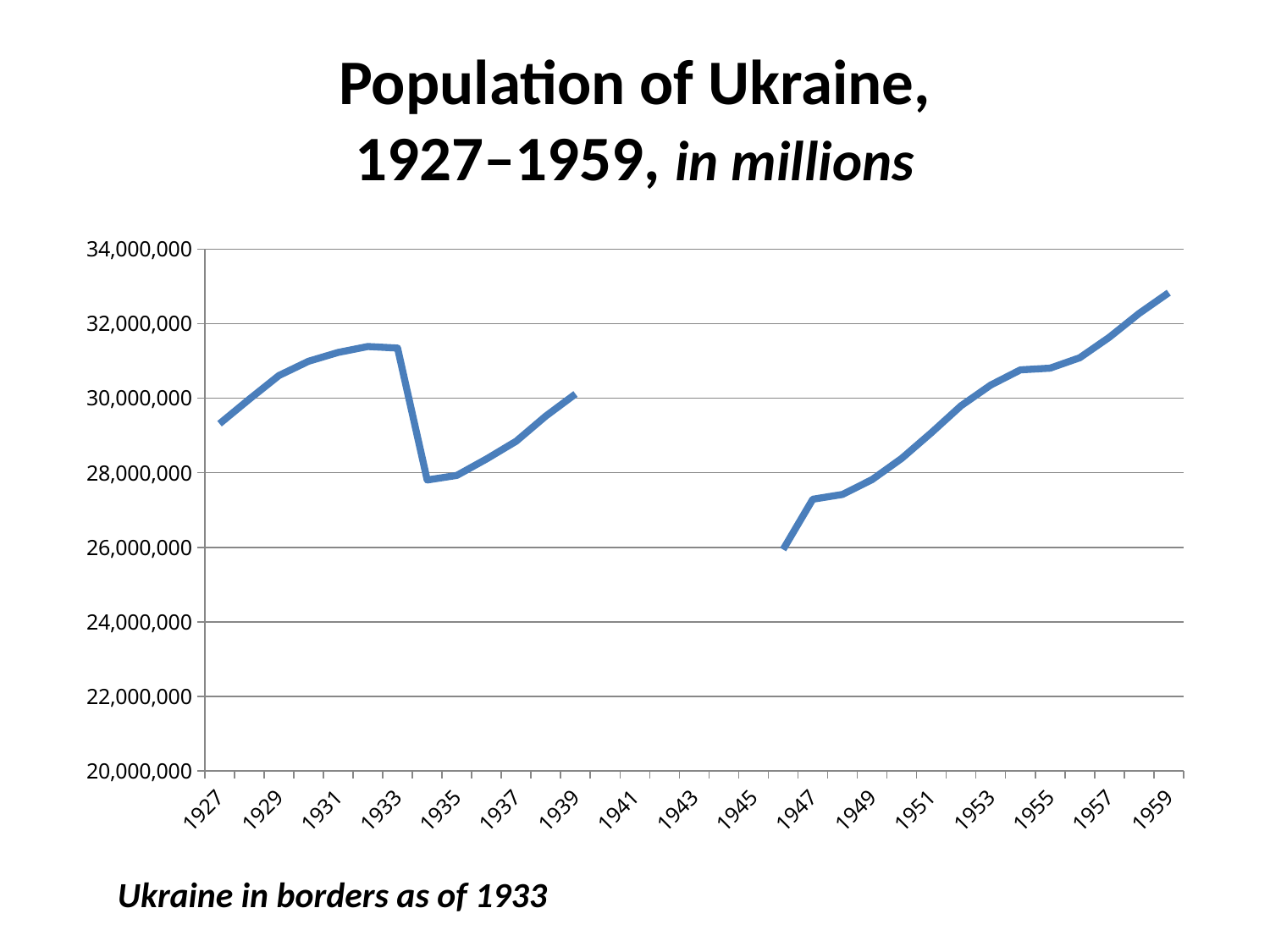
Which year has the highest population value on the chart? 1959 What kind of chart is shown on the slide? Line chart Does the population rise or fall from 1947 to 1959? rise What is the title of the chart? Population of Ukraine, 1927–1959, in millions Is the value for 1927 greater or less than 30,000,000? less Is the value for 1959 greater or less than 32,000,000? greater Is the value for 1934 greater or less than 30,000,000? less Which year has the larger population value, 1933 or 1934? 1933 What note appears below the chart about the borders used? Ukraine in borders as of 1933 Which year has the lowest population value on the chart? 1946